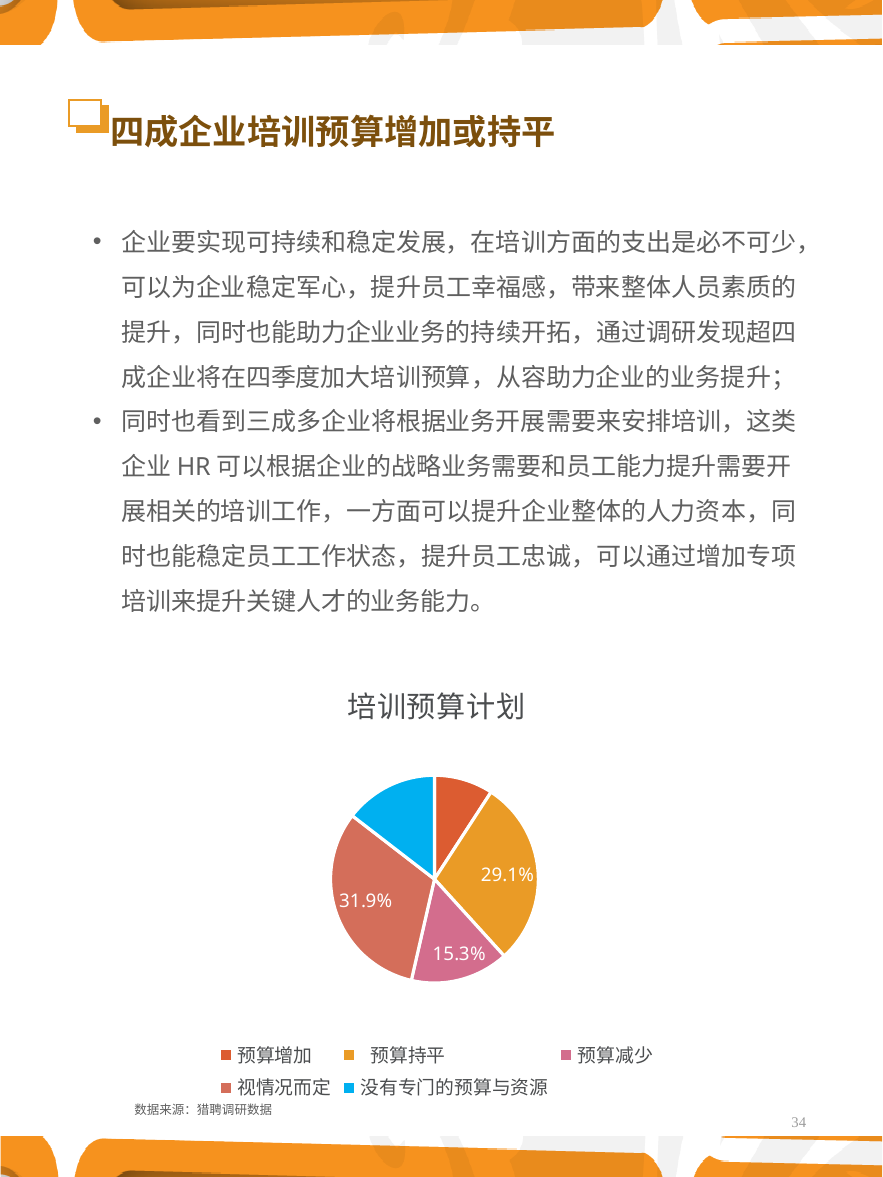
What type of chart is shown on the slide? pie chart What percentage of the pie is 预算持平? 29.1% Which is larger, 视情况而定 or 预算减少? 视情况而定 How many categories does the pie chart have? 5 What share of the pie does 视情况而定 hold? 31.9% Which category has the largest share of the pie? 视情况而定 What colour represents 没有专门的预算与资源 in the chart? blue What value is shown for 预算减少? 15.3% What is the title of the chart? 培训预算计划 Which is larger, 预算持平 or 预算减少? 预算持平 What is the difference between the shares of 视情况而定 and 预算持平? 2.8% What is the difference between the shares of 预算持平 and 预算减少? 13.8%